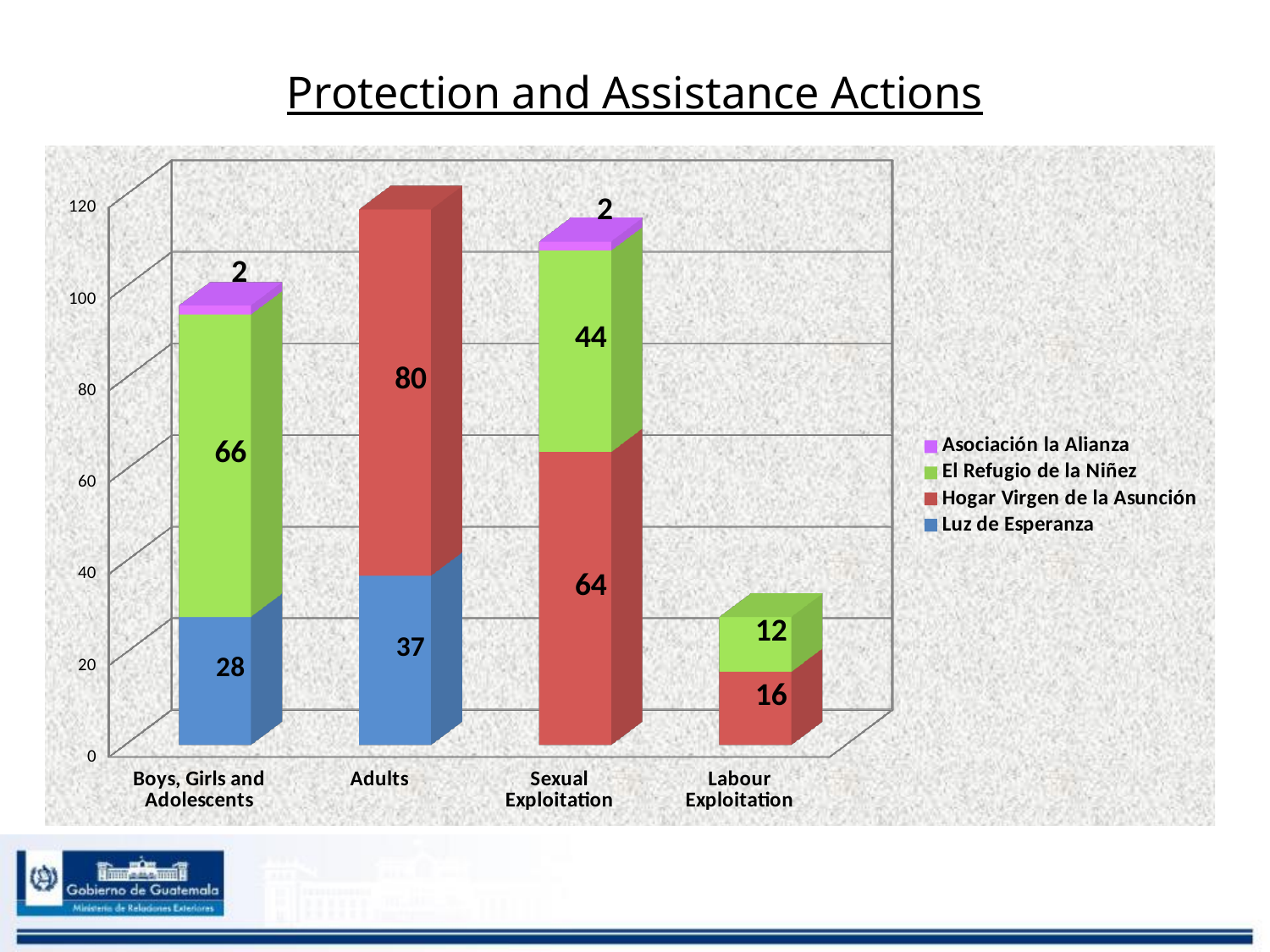
What is the difference between the El Refugio de la Niñez values for Boys, Girls and Adolescents and Sexual Exploitation? 22 Which category has the highest total stacked bar? Adults What is the total of the stacked bar for Labour Exploitation? 28 What kind of chart is shown on the slide? Stacked bar chart What is the total of the stacked bar for Adults? 117 Which category has the lowest total stacked bar? Labour Exploitation Which is larger: the Luz de Esperanza value for Adults or for Boys, Girls and Adolescents? Adults How many series does the legend list? 4 What is the value for Luz de Esperanza in the Boys, Girls and Adolescents category? 28 What is the value for Hogar Virgen de la Asunción in the Labour Exploitation category? 16 What is the value for El Refugio de la Niñez in the Sexual Exploitation category? 44 What is the value for Hogar Virgen de la Asunción in the Adults category? 80